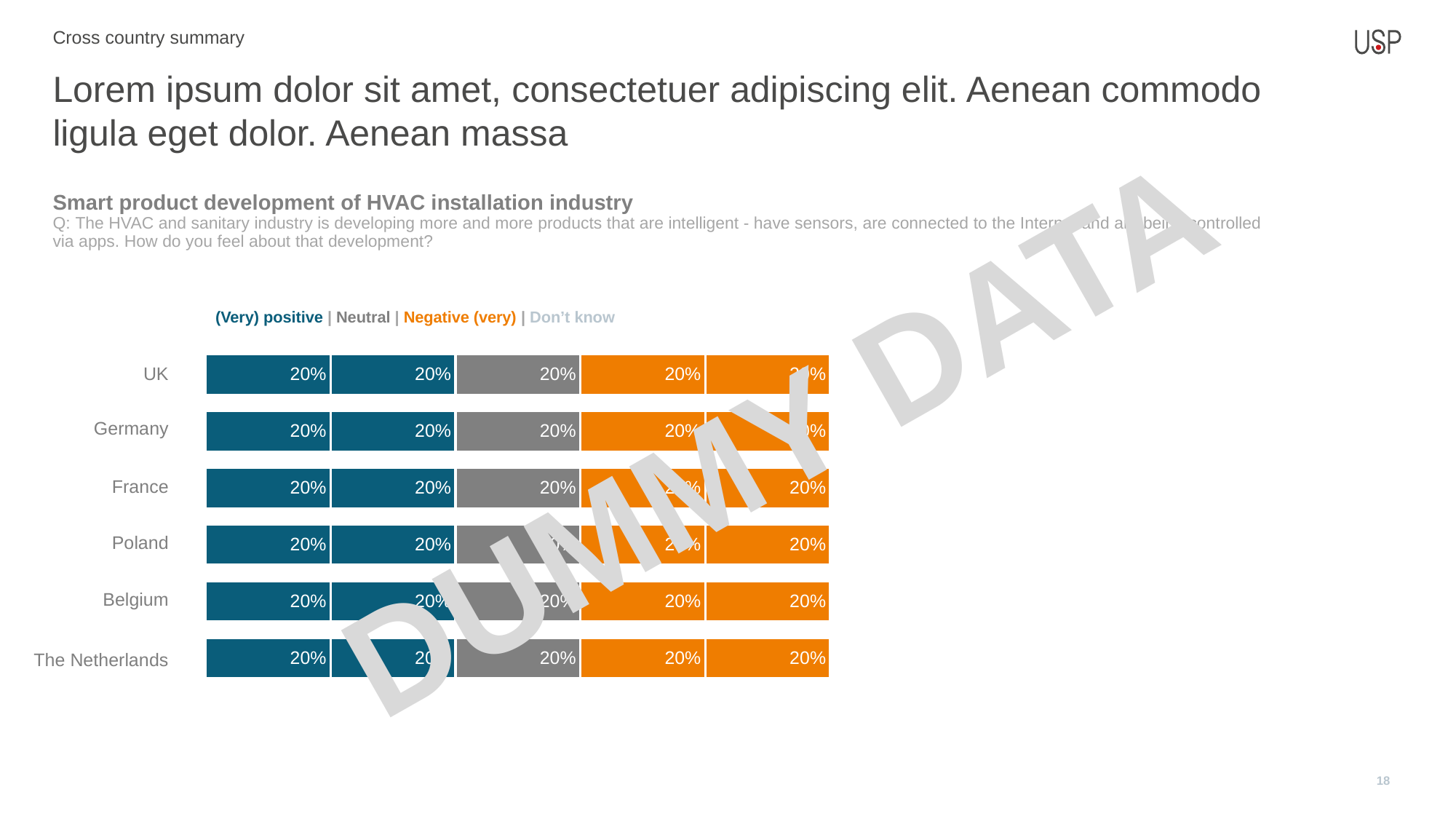
What kind of chart is shown on the slide? Stacked bar chart How many entries does the chart legend list? 4 What is the title of the chart? Smart product development of HVAC installation industry How many countries are listed on the chart? 6 What is the total of the stacked bar for Poland? 100% What is the value of the rightmost segment for The Netherlands? 20% Which country is listed at the bottom of the chart? The Netherlands What is the value of the last (rightmost) segment of the France bar? 20% What is the value of the first (leftmost) segment of the UK bar? 20% What is the difference between the first segment of the UK bar and the first segment of the Germany bar? 0% What is the value of the grey segment for Germany? 20% What is the value of the first segment of the Belgium bar? 20%